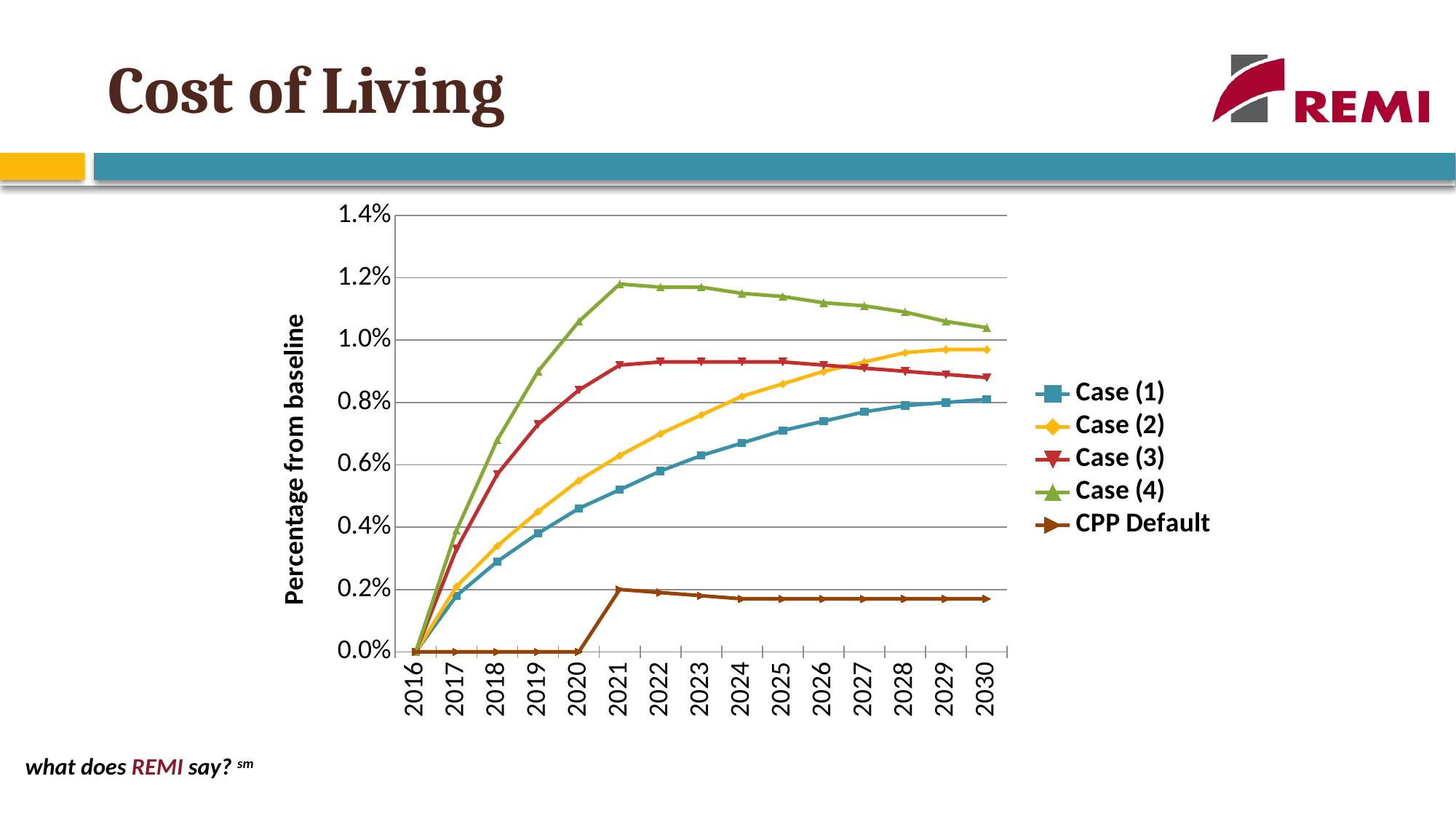
Which series has the lowest value in 2030? CPP Default What is the value for CPP Default in 2020? 0.0% How many years are shown along the x axis? 15 What is the label on the y axis? Percentage from baseline How many series does the legend list? 5 Does the Case (4) line rise or fall from 2021 to 2030? fall What kind of chart is shown on the slide? line chart Is the value for Case (4) in 2021 greater or less than 1.0%? greater Which is larger in 2030, Case (2) or Case (3)? Case (2) What is the value for Case (1) in 2016? 0.0% Which series has the highest value in 2021? Case (4) Is the value for Case (1) in 2030 greater or less than 1.0%? less